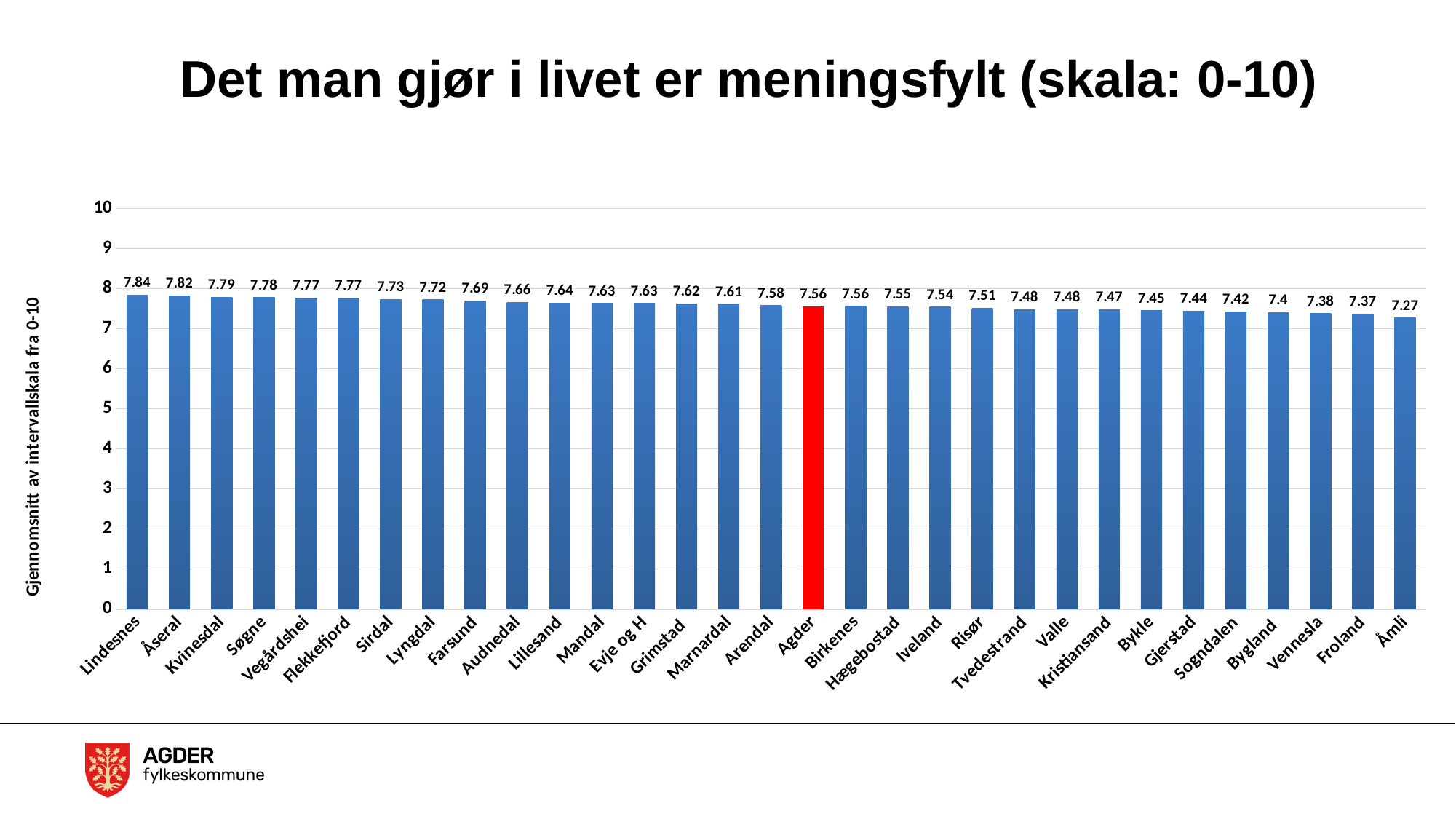
Which bar is coloured red instead of blue? Agder What is the value for Åmli? 7.27 Which category has the lowest value? Åmli What is the value for Kristiansand? 7.47 What is the difference between the values for Agder and Arendal? 0.02 Is the value for Grimstad greater or less than 7? greater Which category has the highest value? Lindesnes How many categories are shown on the x axis? 31 Which has a higher value, Søgne or Vennesla? Søgne What kind of chart is shown on the slide? Bar chart What is the difference between the values for Lindesnes and Åmli? 0.57 What is the value for Agder? 7.56